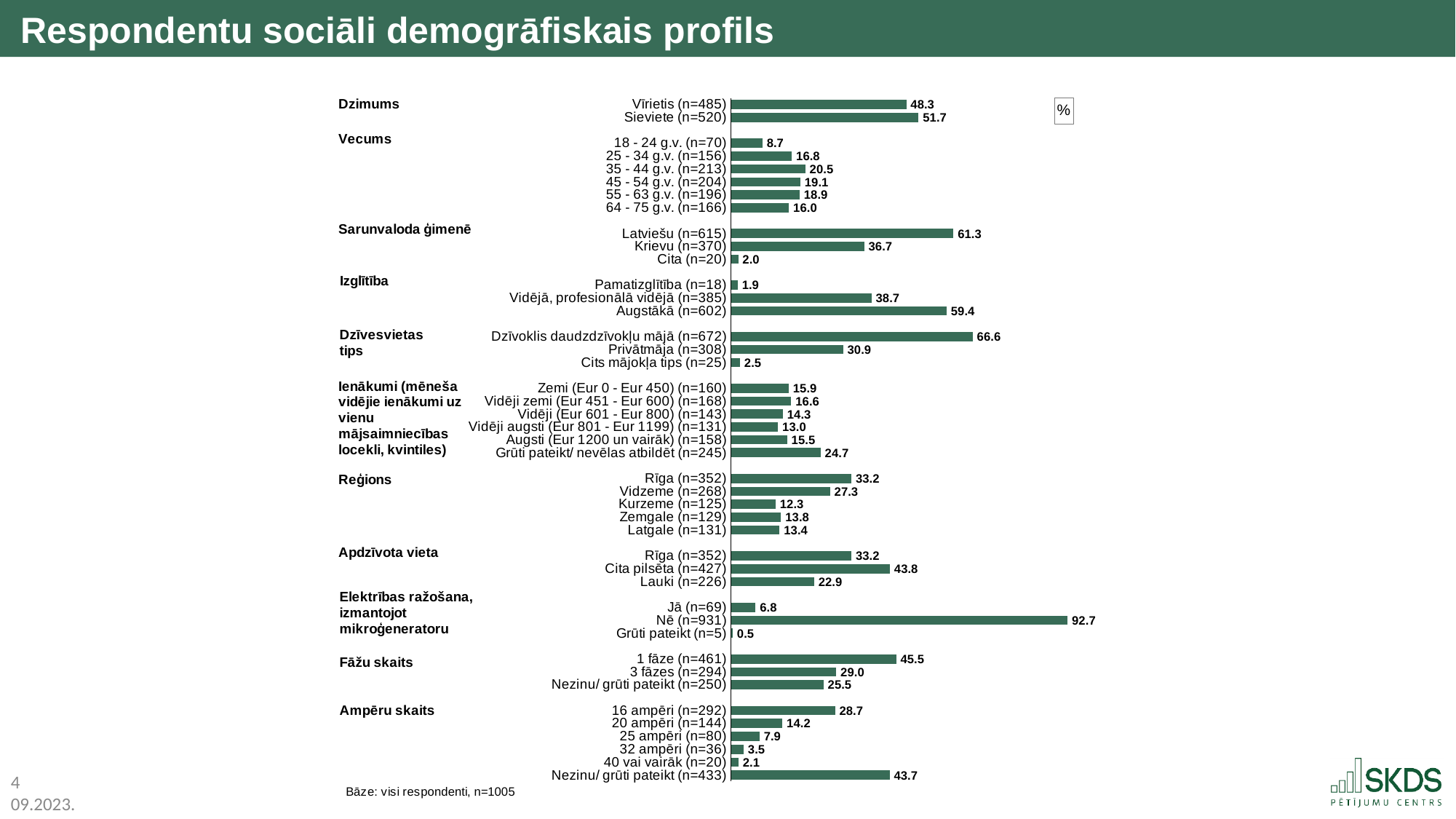
What is the value for Latviešu (n=615) under Sarunvaloda ģimenē? 61.3 What is the difference between the values for Dzīvoklis daudzdzīvokļu mājā (n=672) and Privātmāja (n=308)? 35.7 How many age groups are listed under Vecums? 6 What is the value for Sieviete (n=520)? 51.7 Under Reģions, which is larger: Rīga (n=352) or Vidzeme (n=268)? Rīga (n=352) What is the value for 1 fāze (n=461)? 45.5 What is the difference between the values for Sieviete (n=520) and Vīrietis (n=485)? 3.4 Which category has the highest value on the chart? Nē (n=931) What kind of chart is shown on the slide? Bar chart What is the value for Augstākā (n=602)? 59.4 Which category has the lowest value on the chart? Grūti pateikt (n=5) What unit is indicated for the values on the chart? %